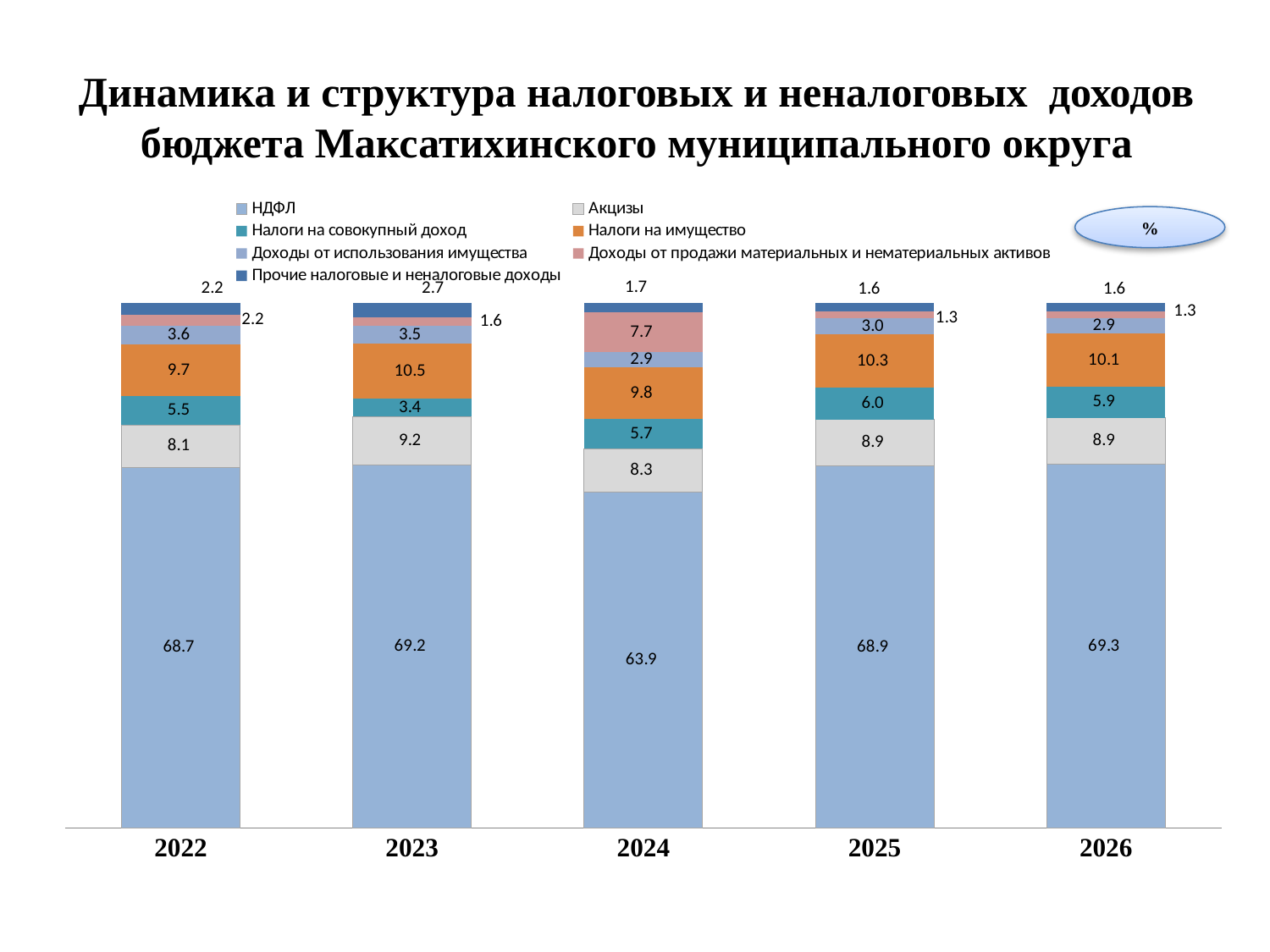
What kind of chart is shown on the slide? Stacked bar chart In which year is the Доходы от продажи материальных и нематериальных активов value the highest? 2024 Which year has the larger Акцизы value, 2022 or 2023? 2023 What is the value of Акцизы for 2026? 8.9 How many years are shown on the x axis? 5 What is the difference between the Налоги на имущество values for 2023 and 2022? 0.8 How many series does the legend list? 7 What is the value of Налоги на имущество for 2023? 10.5 In which year is the НДФЛ value the lowest? 2024 What is the value of Доходы от продажи материальных и нематериальных активов for 2024? 7.7 What is the total of the stacked bar for 2022? 100.0 What is the value of НДФЛ for 2024? 63.9